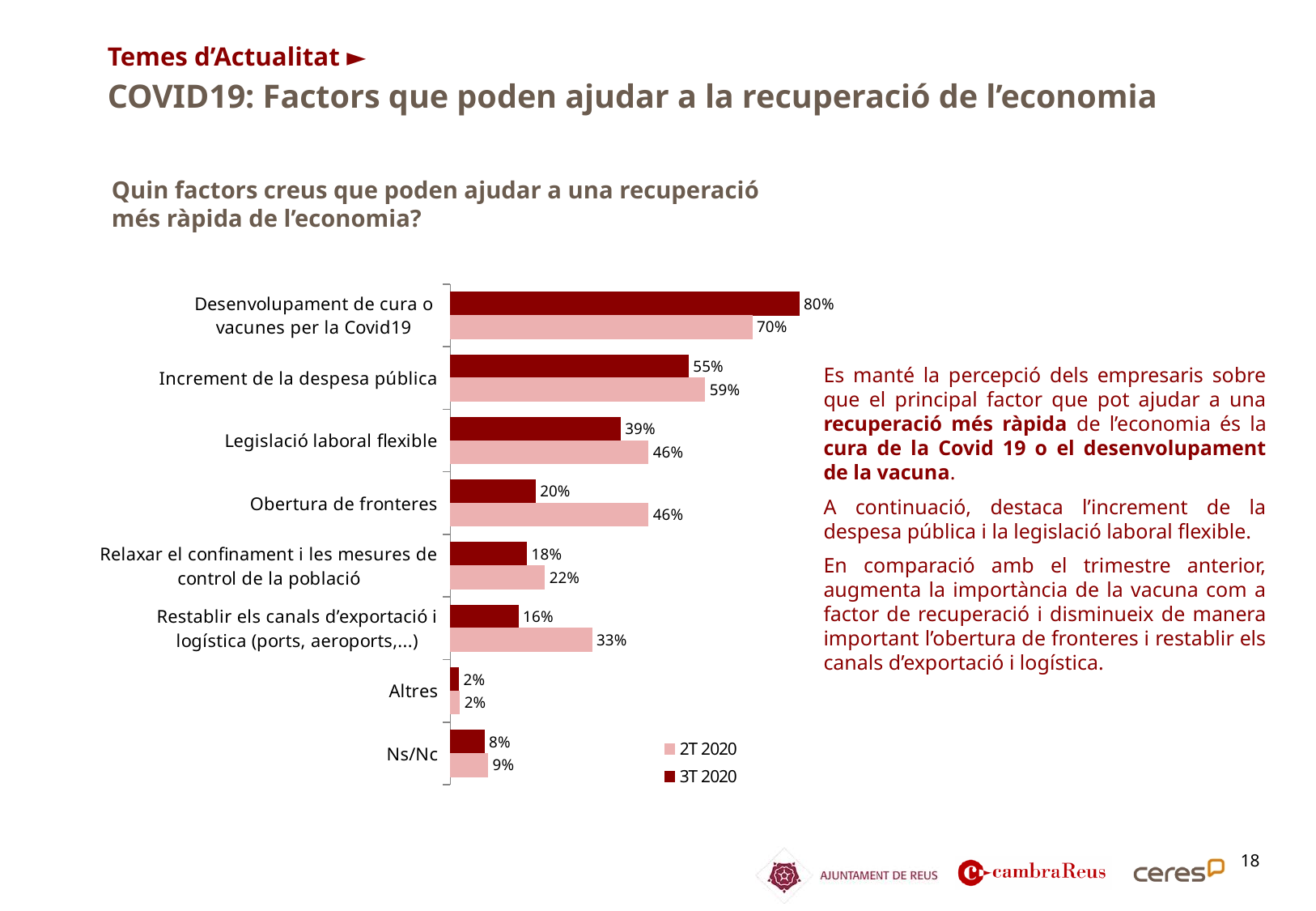
For "Increment de la despesa pública", which series has the larger value, 2T 2020 or 3T 2020? 2T 2020 How many categories are shown on the chart? 8 What is the value for "Desenvolupament de cura o vacunes per la Covid19" in the 3T 2020 series? 80% What kind of chart is shown on the slide? Bar chart Which category has the highest value in the 3T 2020 series? Desenvolupament de cura o vacunes per la Covid19 What is the difference between the 2T 2020 and 3T 2020 values for "Obertura de fronteres"? 26% What is the value for "Obertura de fronteres" in the 2T 2020 series? 46% Which category has the lowest value in the 2T 2020 series? Altres What is the value for "Restablir els canals d'exportació i logística (ports, aeroports,...)" in the 3T 2020 series? 16% What is the difference between the 3T 2020 and 2T 2020 values for "Desenvolupament de cura o vacunes per la Covid19"? 10% How many series does the legend list? 2 For "Legislació laboral flexible", which series has the larger value, 2T 2020 or 3T 2020? 2T 2020